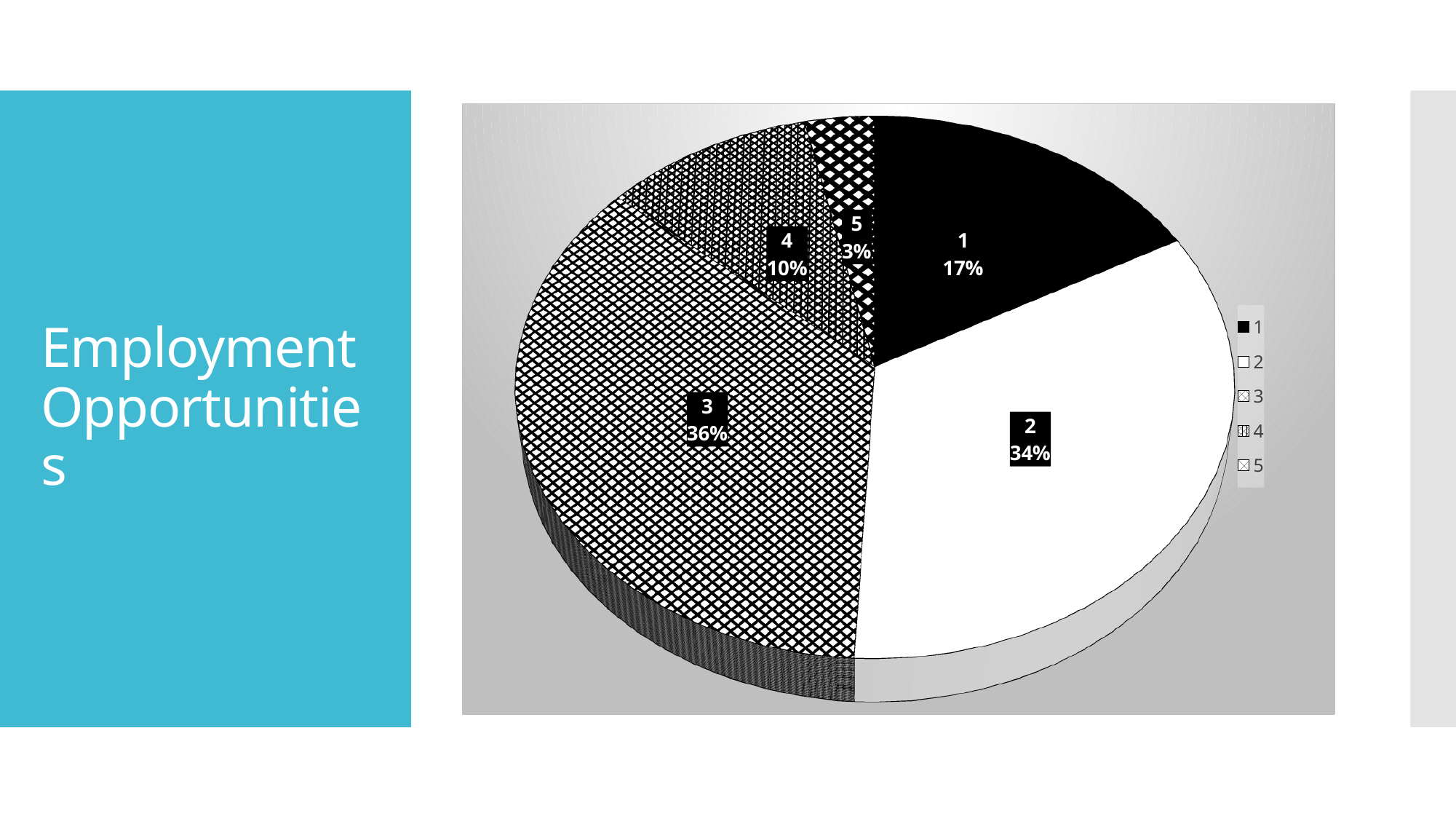
Which is larger, the share of slice 4 or the share of slice 5? 4 What percentage share does slice 3 have? 36% What is the difference in percentage points between slice 2 and slice 1? 17 What percentage share does slice 1 have? 17% Which slice has the smallest share of the pie? 5 How many entries does the legend list? 5 What kind of chart is shown on the slide? pie chart What percentage share does slice 2 have? 34% How many slices does the pie chart have? 5 Which slice has the largest share of the pie? 3